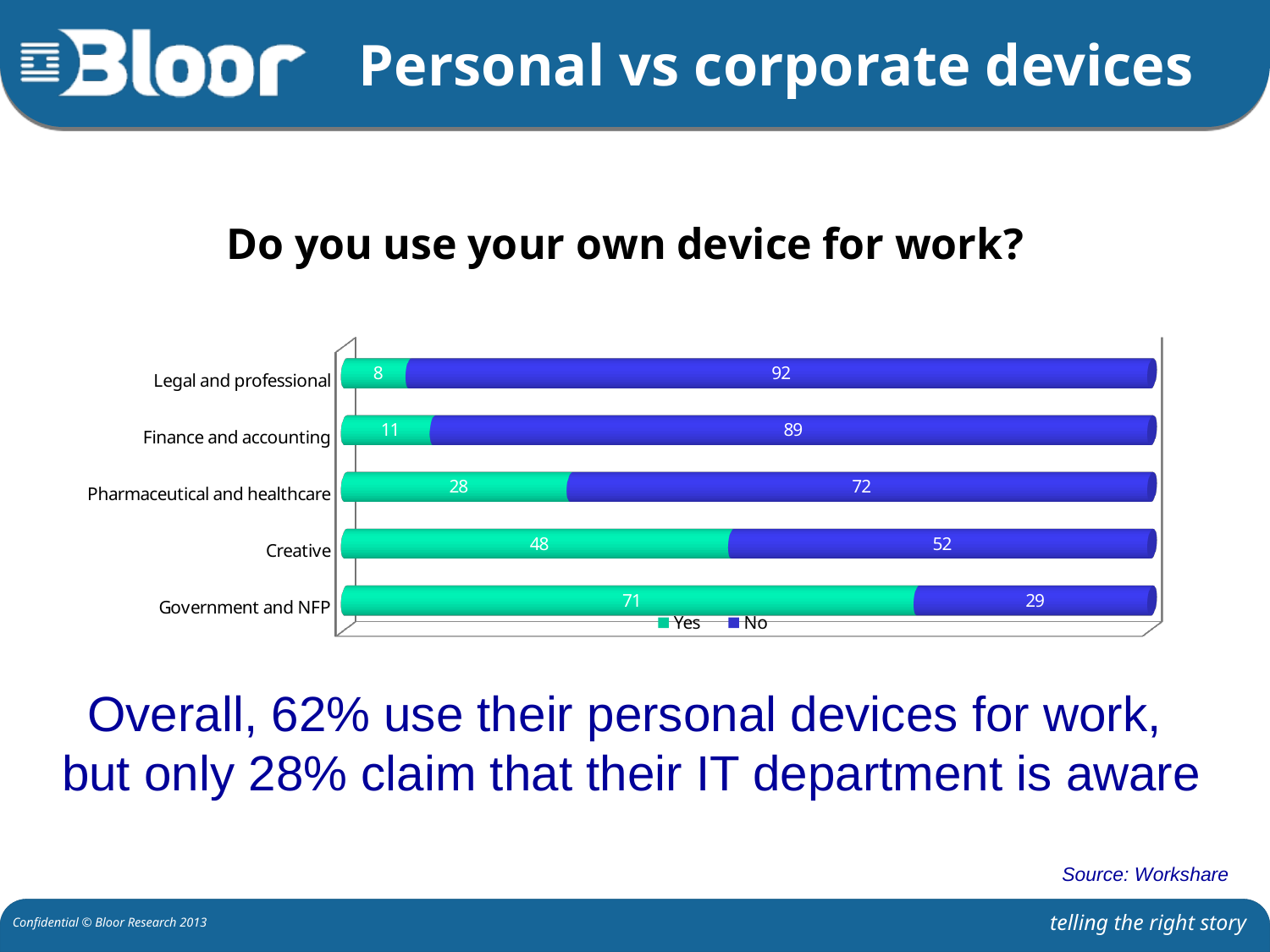
What is the 'No' value for Legal and professional? 92 How many series does the legend list? 2 What is the 'Yes' value for Pharmaceutical and healthcare? 28 What is the difference between the 'No' and 'Yes' values for Finance and accounting? 78 What is the title of the chart? Do you use your own device for work? What is the total of the stacked bar for Government and NFP? 100 What kind of chart is shown on the slide? Stacked bar chart What is the 'Yes' value for Creative? 48 Which category has the lowest 'Yes' value? Legal and professional Which category has the highest 'Yes' value? Government and NFP Which is larger for Creative, the 'Yes' value or the 'No' value? No How many categories are shown on the chart? 5